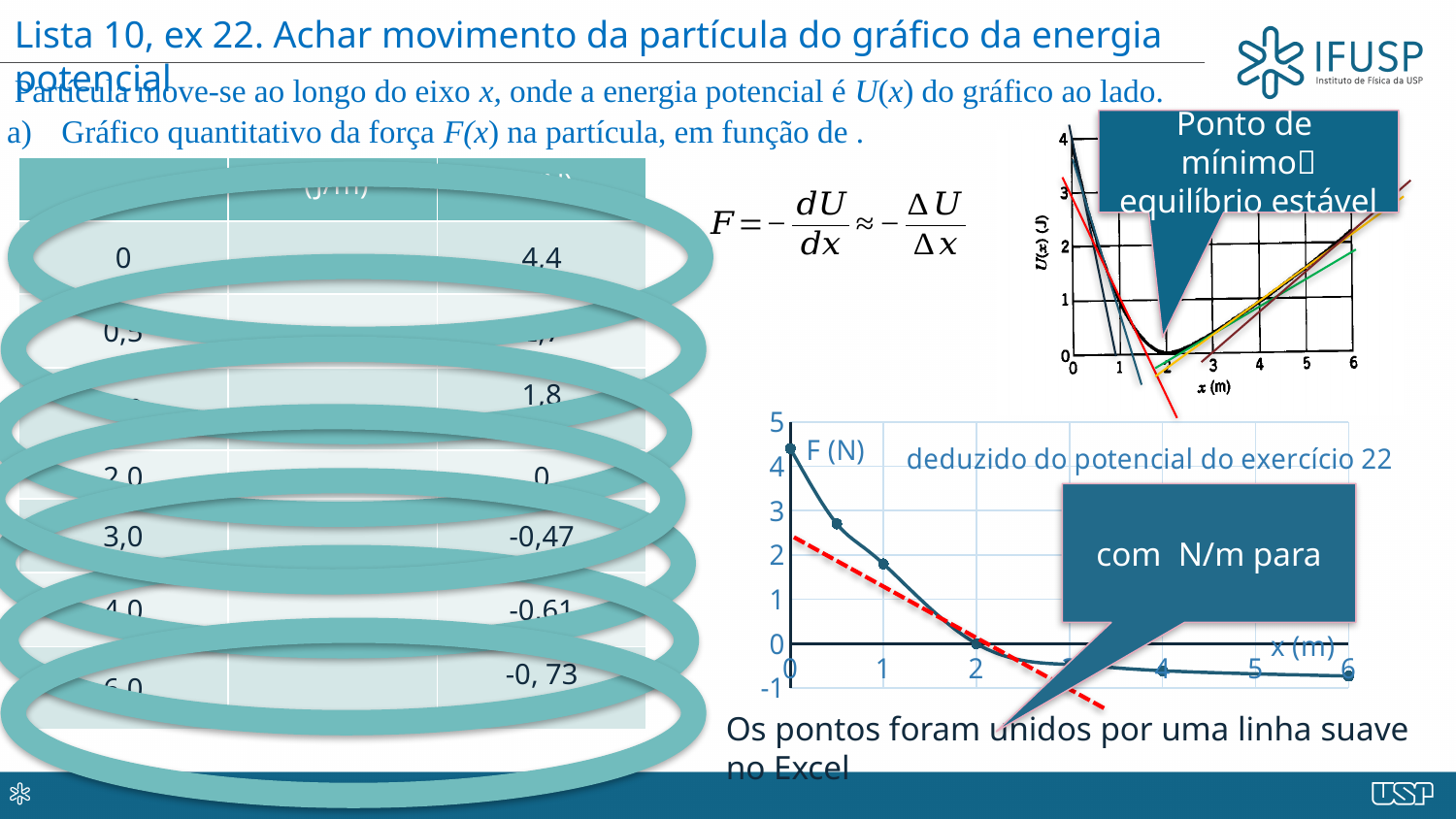
How many data points are plotted on the F (N) chart? 7 On the F (N) chart, which is larger: the force at x = 1 or the force at x = 3? x = 1 On the F (N) chart, at which x value is the force lowest? 6 On the F (N) chart, is the value of F at x = 0.5 greater or less than 2? greater What is the label of the vertical axis on the force chart? F (N) On the F (N) chart, at which x value is the force highest? 0 On the F (N) chart, is the value of F at x = 1 greater or less than 1? greater On the F (N) chart, what is the value of F at x = 2 m? 0 What kind of chart is the F (N) versus x (m) chart on the slide? line chart On the F (N) chart, do the values rise or fall as x increases? fall On the F (N) chart, is the value of F at x = 0 greater or less than 4? greater